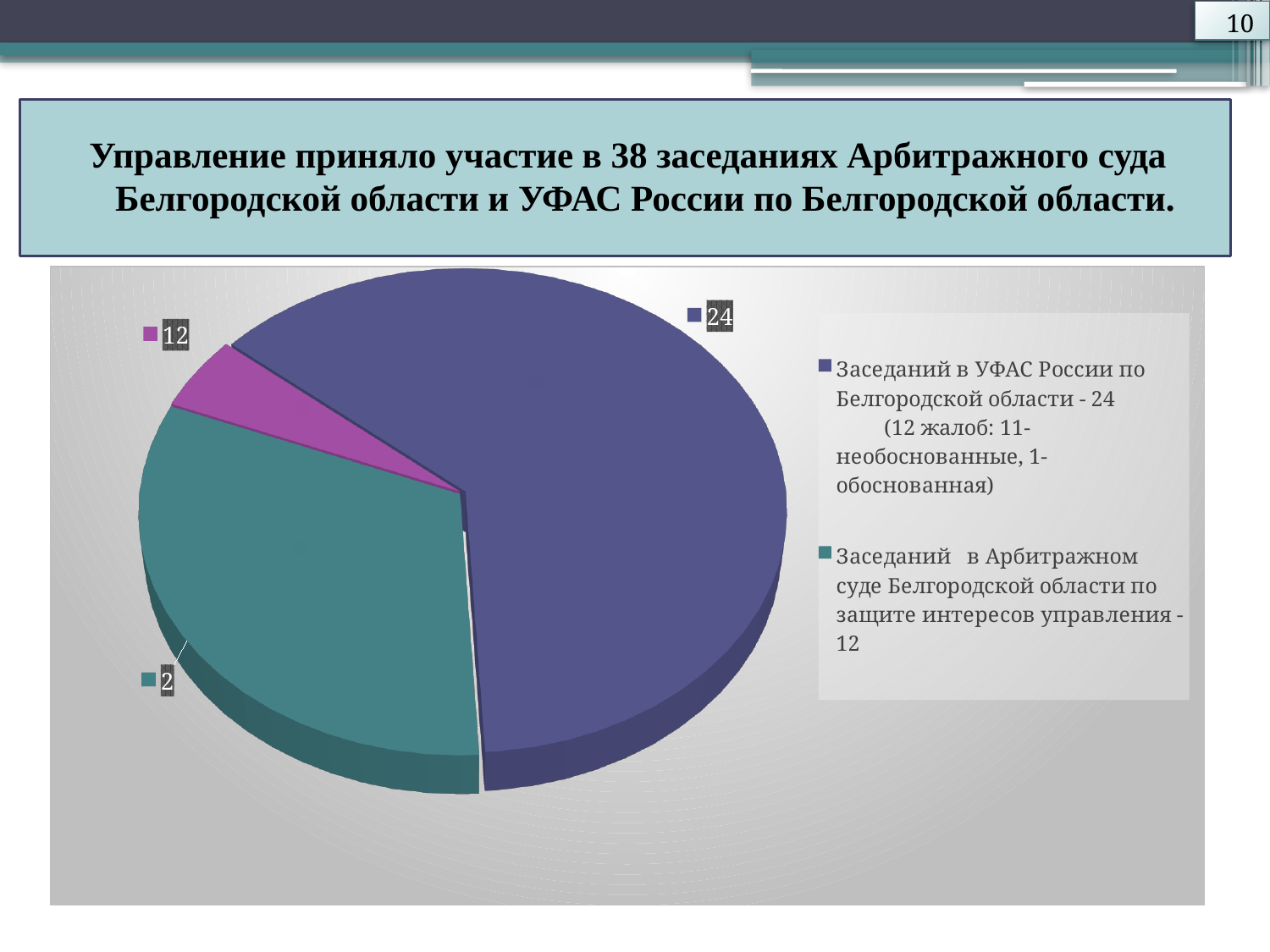
Which is larger: the number of meetings at УФАС or the number of meetings in the Арбитражный суд? Meetings at УФАС How many entries does the legend of the pie chart list? 2 According to the legend, how many meetings were held in the Арбитражный суд Белгородской области to protect the interests of the administration? 12 According to the slide title, in how many meetings did the administration take part? 38 What is the total of the three values labelled on the pie chart (24, 12 and 2)? 38 How many slices does the pie chart have? 3 According to the legend, how many meetings were held at УФАС России по Белгородской области? 24 Which category has the largest slice in the pie chart? Заседаний в УФАС России по Белгородской области - 24 What colour is the slice for meetings at УФАС России по Белгородской области? Blue-purple What kind of chart is shown on the slide? Pie chart What is the difference between the number of meetings at УФАС (24) and the number of meetings in the Арбитражный суд (12)? 12 What is the smallest value labelled on the pie chart? 2